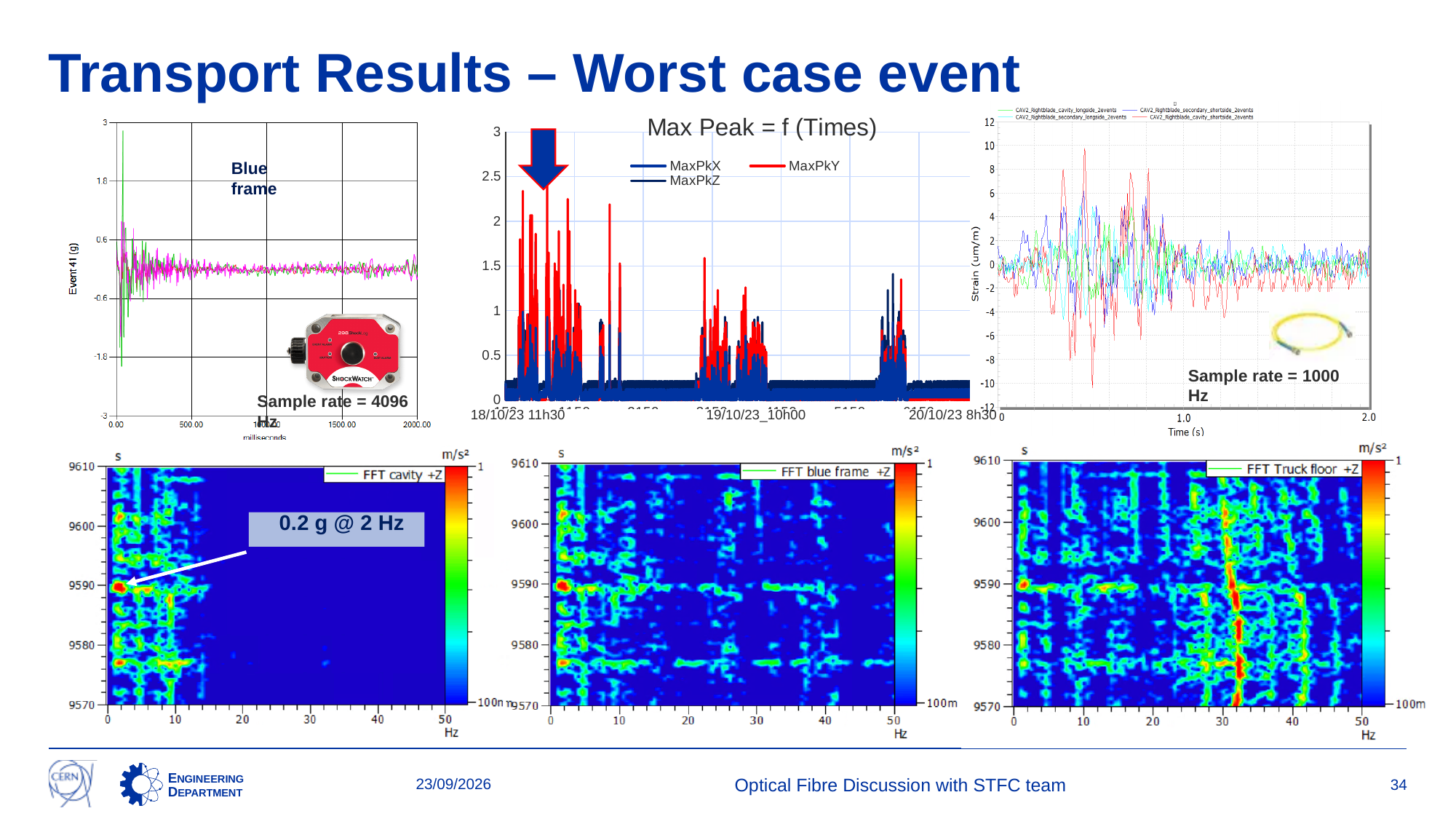
On the 'Max Peak = f (Times)' chart, which series is drawn in red? MaxPkY On the top-right strain chart, is the largest positive strain peak greater or less than 8? greater On the 'Max Peak = f (Times)' chart, how many series does the legend list? 3 On the top-right strain chart, how many series does the legend list? 4 How many spectrogram (FFT) charts are shown along the bottom of the slide? 3 On the 'FFT cavity +Z' spectrogram, what value is annotated by the arrow? 0.2 g @ 2 Hz On the top-right strain chart, is the lowest strain value greater or less than -8? less On the 'Max Peak = f (Times)' chart, is the highest MaxPkY peak greater or less than 2? greater What kind of chart is the top-left 'Blue frame' chart? line chart What kind of chart is the 'Max Peak = f (Times)' chart? line chart